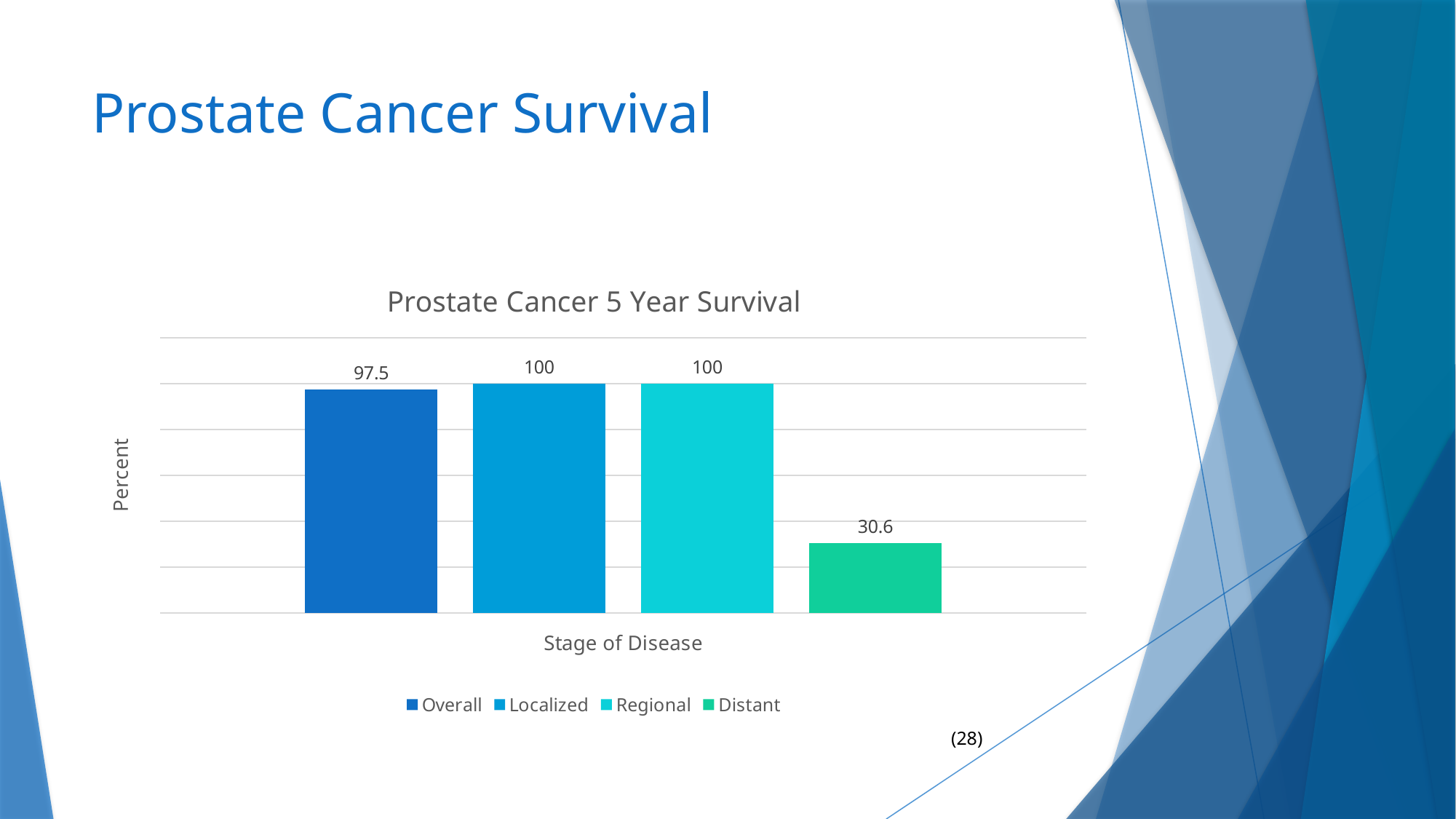
What is the value for Localized in the Prostate Cancer 5 Year Survival chart? 100 What is the difference between the Localized and Distant values? 69.4 What is the difference between the Regional and Overall values? 2.5 Which is larger, the value for Overall or the value for Distant? Overall How many bars are plotted in the chart? 4 What is the value for Regional in the Prostate Cancer 5 Year Survival chart? 100 What is the value for Overall in the Prostate Cancer 5 Year Survival chart? 97.5 What is the label of the x axis of the chart? Stage of Disease What is the value for Distant in the Prostate Cancer 5 Year Survival chart? 30.6 Which stage has the lowest 5 year survival in the chart? Distant How many entries does the legend list? 4 What kind of chart is shown on the slide? Bar chart